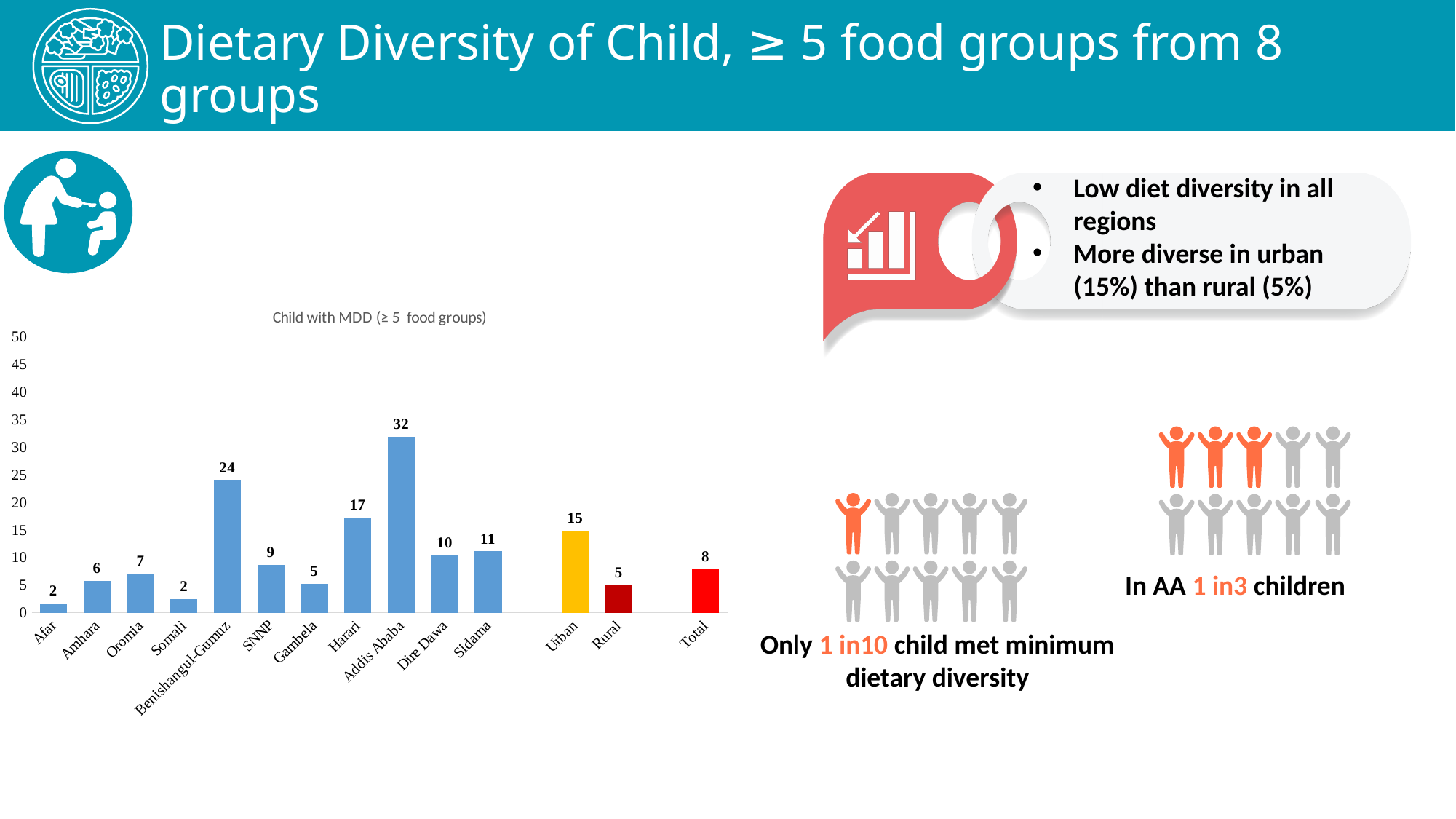
Which category has the highest value in the chart? Addis Ababa What is the value for Addis Ababa in the chart? 32 Which is larger, the value for Dire Dawa or the value for Sidama? Sidama What is the title of the chart? Child with MDD (≥ 5 food groups) Which is larger, the value for Amhara or the value for Oromia? Oromia What is the difference between the values for Urban and Rural? 10 What kind of chart is shown on the slide? Bar chart How many categories are plotted in the chart? 14 What is the value for Urban in the chart? 15 What is the difference between the values for Addis Ababa and Harari? 15 What is the value for Benishangul-Gumuz in the chart? 24 What is the value for Total in the chart? 8